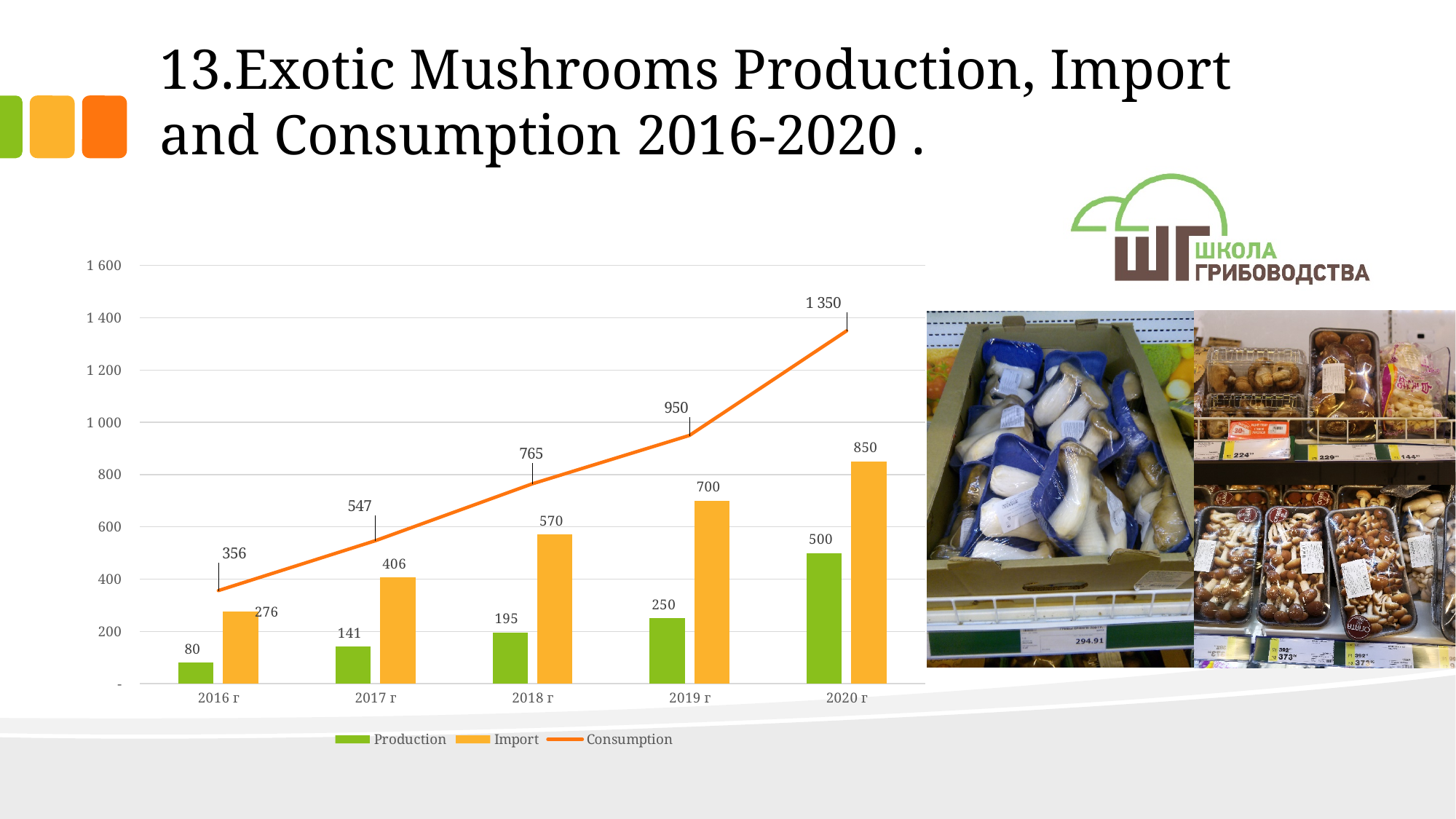
Does Consumption rise or fall from 2016 г to 2020 г? rise In which year is Production lowest? 2016 г Which is larger in 2020 г, Production or Import? Import What is the Consumption value for 2020 г? 1 350 What is the Production value for 2018 г? 195 How many series does the legend list? 3 How many years are shown on the x axis? 5 Which series is drawn as a line rather than bars? Consumption What is the Import value for 2019 г? 700 In which year is Import highest? 2020 г What is the difference between Import and Production in 2017 г? 265 Is the Consumption value for 2019 г greater or less than 800? greater